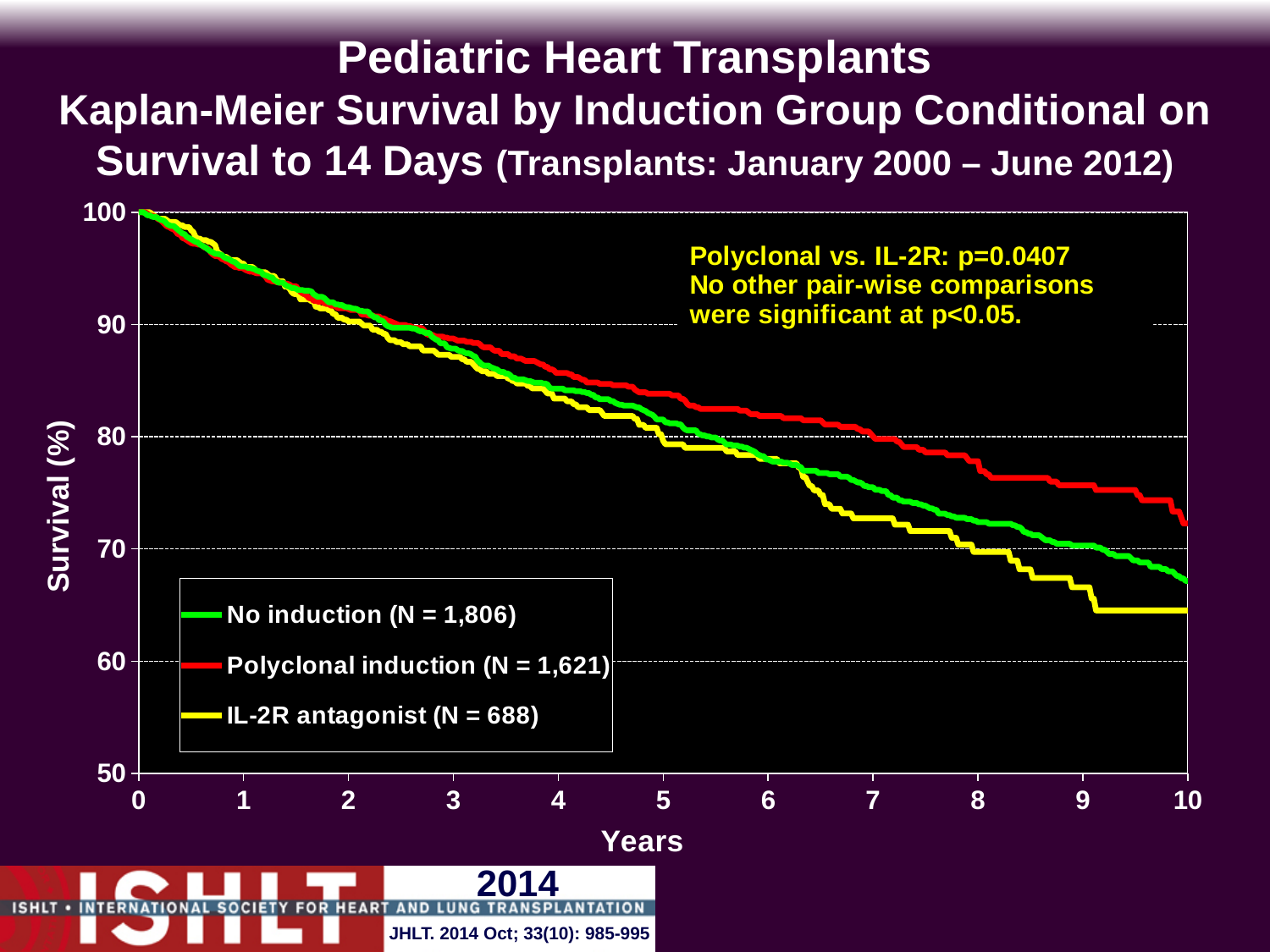
Which series has the lowest survival at 10 years? IL-2R antagonist What is the survival value for all three groups at year 0? 100 How many series does the legend list? 3 Which series has the highest survival at 10 years? Polyclonal induction Is the survival for IL-2R antagonist at 10 years greater or less than 70? less Is the survival for Polyclonal induction at 10 years greater or less than 70? greater Do the survival curves rise or fall as years increase? fall What kind of chart is shown on the slide? Line chart Is the survival for Polyclonal induction at 8 years greater or less than 70? greater What is the N for the No induction group shown in the legend? 1,806 At 10 years, which has higher survival: Polyclonal induction or IL-2R antagonist? Polyclonal induction